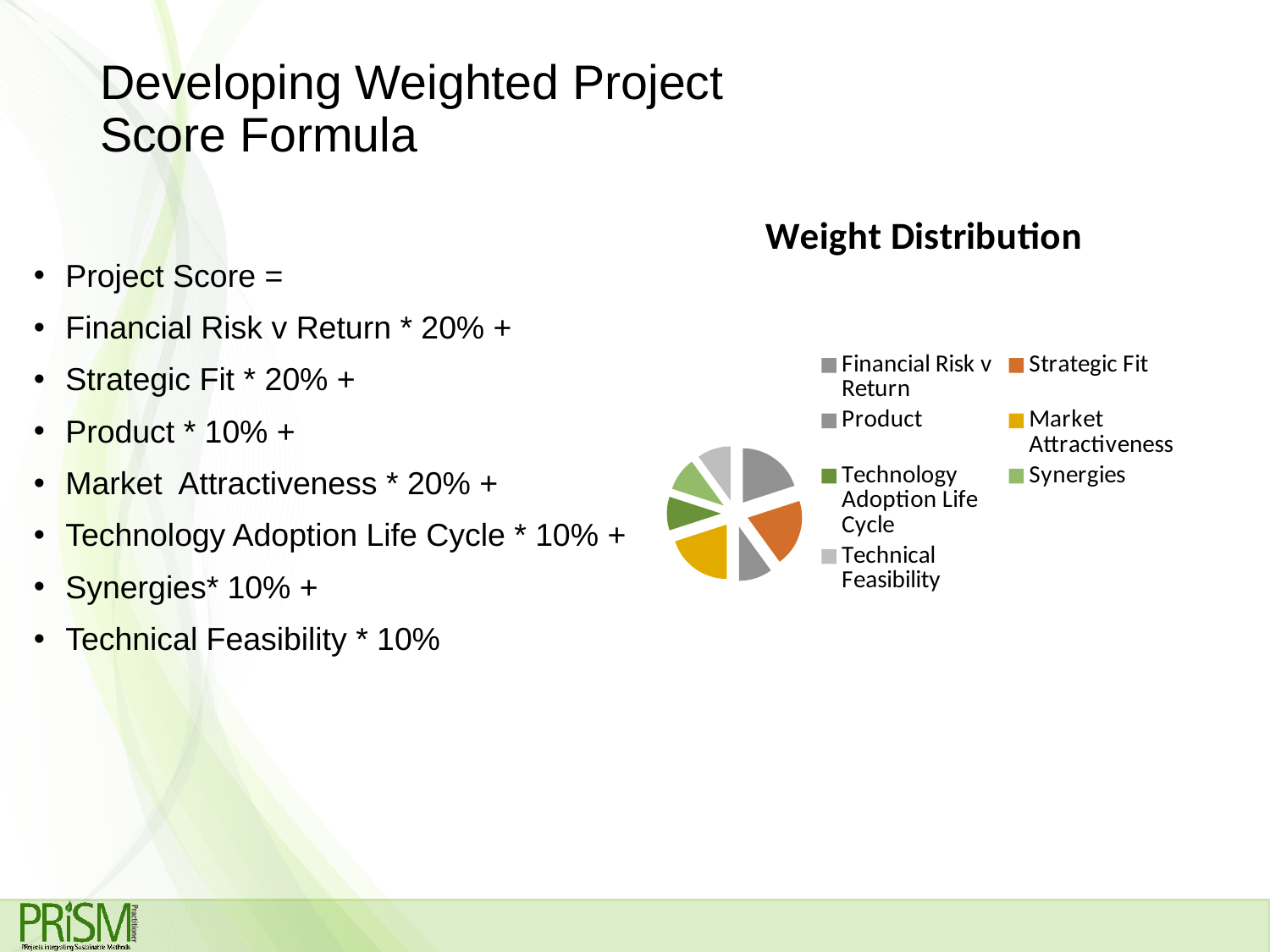
What kind of chart is shown under the title "Weight Distribution"? pie chart Which legend entry in the Weight Distribution pie chart is shown in yellow? Market Attractiveness What colour represents Strategic Fit in the Weight Distribution pie chart? orange In the Weight Distribution pie chart, which slice is larger: Strategic Fit or Technical Feasibility? Strategic Fit How many categories does the legend of the Weight Distribution pie chart list? 7 In the Weight Distribution pie chart, which slice is larger: Market Attractiveness or Synergies? Market Attractiveness What is the title of the chart on the slide? Weight Distribution How many slices does the Weight Distribution pie chart have? 7 In the Weight Distribution pie chart, which slice is larger: Financial Risk v Return or Product? Financial Risk v Return